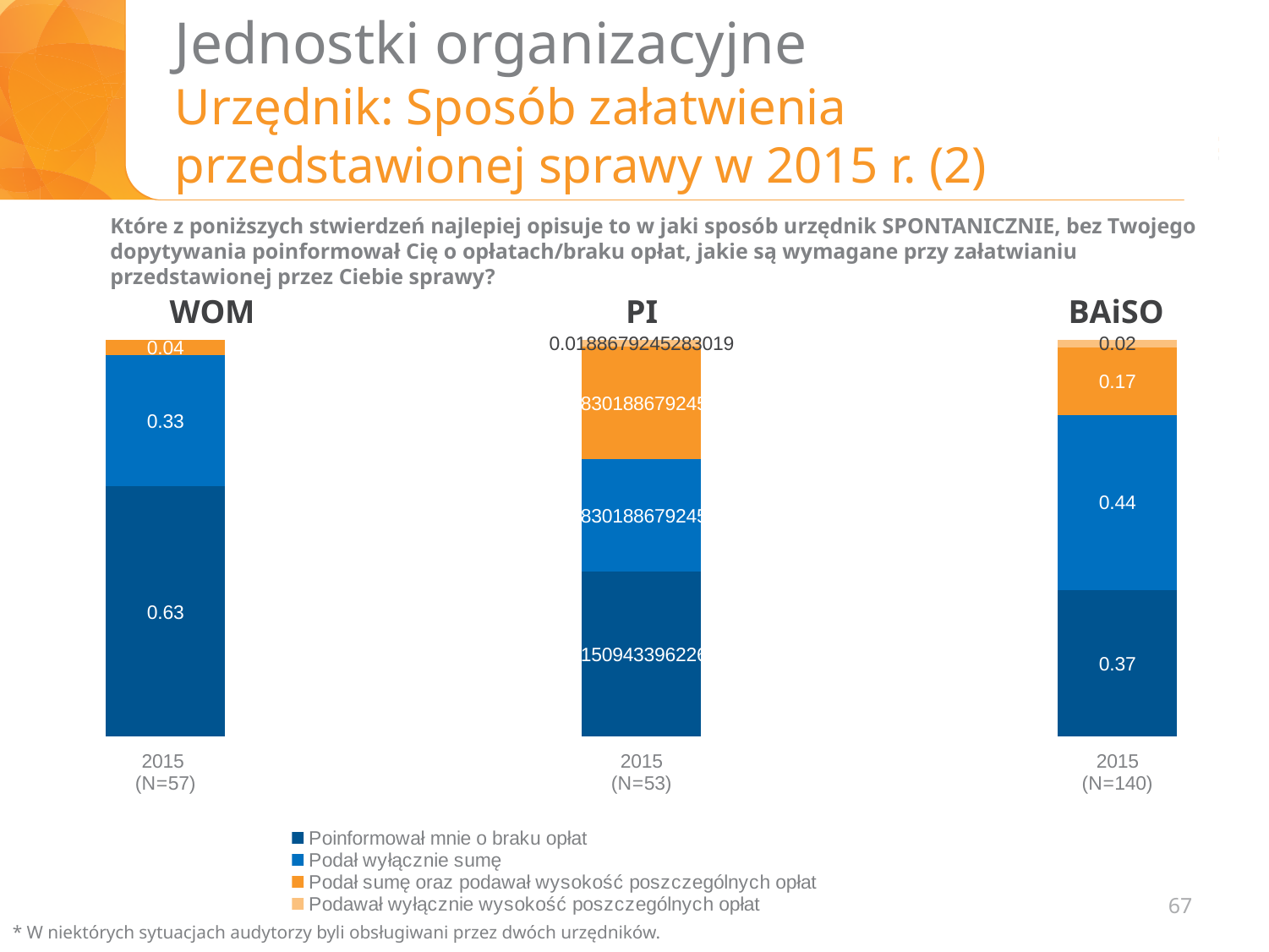
In the BAiSO chart, what is the value for 'Podał wyłącznie sumę'? 0.44 In the WOM chart, what is the difference between 'Poinformował mnie o braku opłat' and 'Podał wyłącznie sumę'? 0.30 What kind of chart is the BAiSO chart? Stacked bar chart In the BAiSO chart, which series has the largest segment? Podał wyłącznie sumę In the WOM chart, what is the value for 'Podał sumę oraz podawał wysokość poszczególnych opłat'? 0.04 In the WOM chart, what is the value for 'Poinformował mnie o braku opłat'? 0.63 How many series does the legend list? 4 Which chart has the larger value for 'Podał sumę oraz podawał wysokość poszczególnych opłat', WOM or BAiSO? BAiSO In the BAiSO chart, what is the value for 'Podawał wyłącznie wysokość poszczególnych opłat'? 0.02 In the BAiSO chart, what is the value for 'Poinformował mnie o braku opłat'? 0.37 In the WOM chart, which series has the largest segment? Poinformował mnie o braku opłat In the WOM chart, what is the value for 'Podał wyłącznie sumę'? 0.33